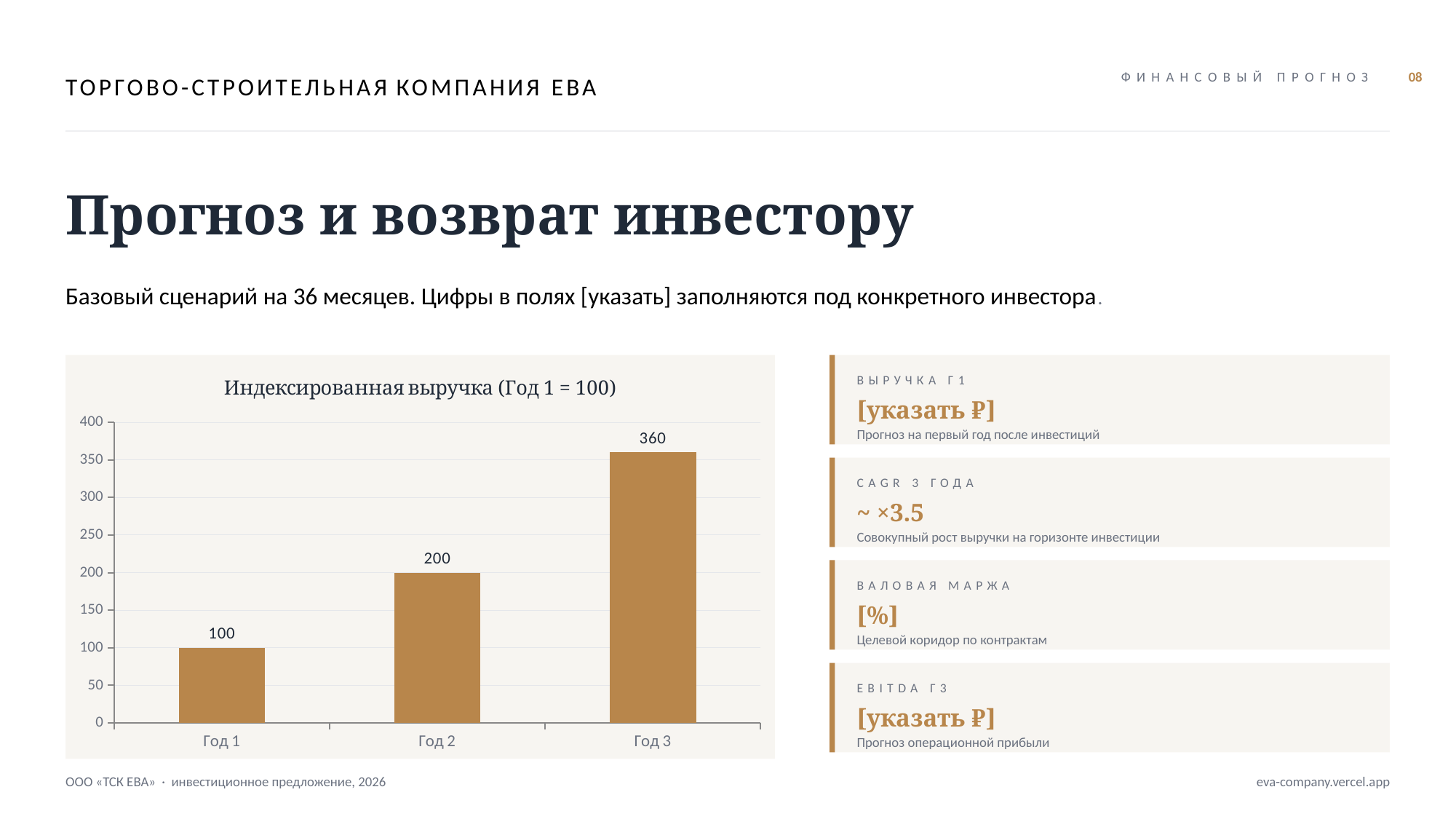
What is the value for Год 1 in the chart? 100 What is the difference between the values for Год 3 and Год 2? 160 What is the value for Год 3 in the chart? 360 Do the values rise or fall from Год 1 to Год 3? rise Which year has the lowest value in the chart? Год 1 How many categories are shown on the x axis of the chart? 3 Is the value for Год 3 greater or less than 300? greater Which is larger, the value for Год 2 or the value for Год 3? Год 3 What is the value for Год 2 in the chart? 200 What is the difference between the values for Год 2 and Год 1? 100 What kind of chart is shown on the slide? bar chart Which year has the highest value in the chart? Год 3